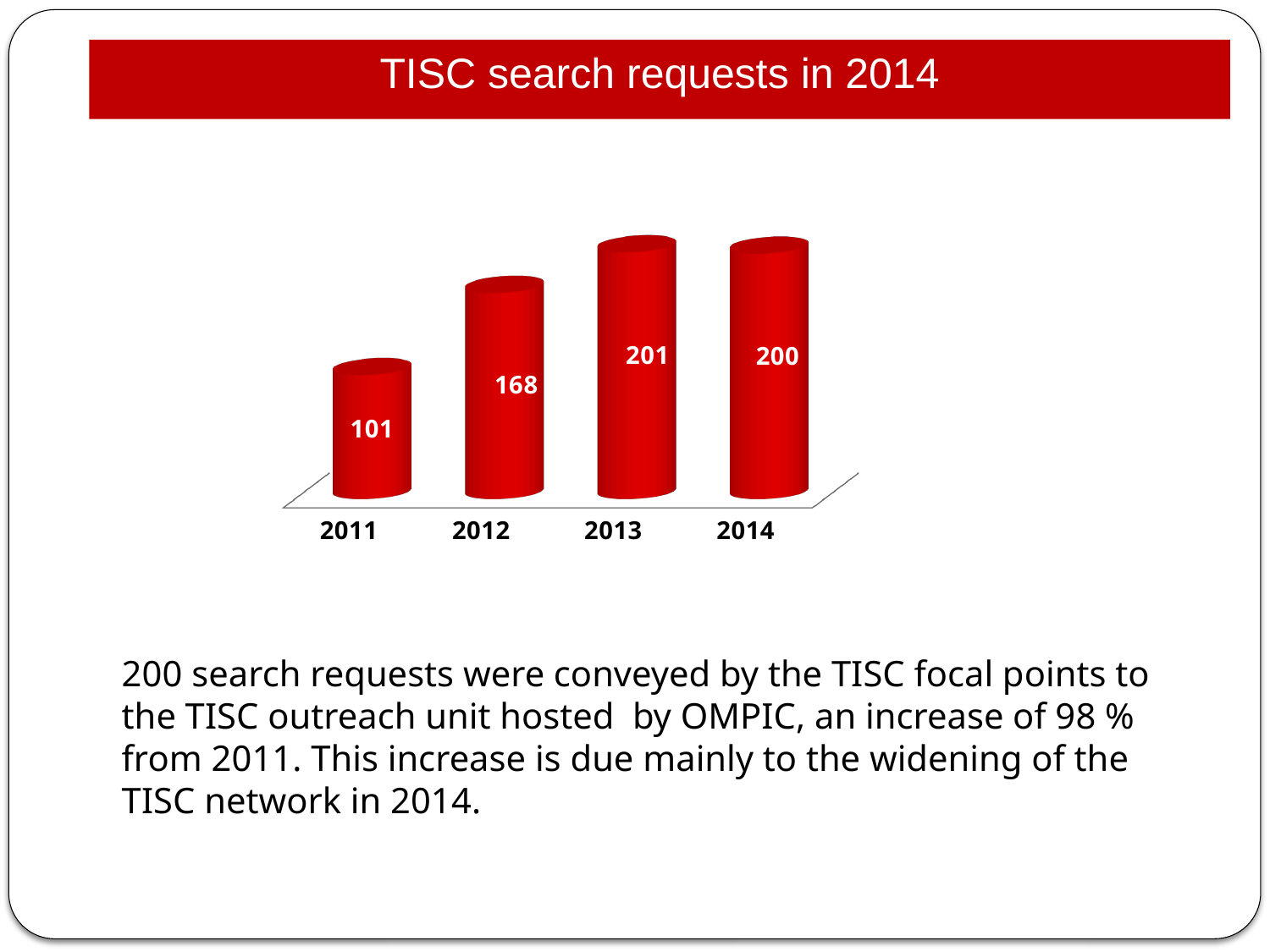
What is the value for 2012? 168 What is the value for 2013? 201 What is the value for 2011? 101 What kind of chart is shown on the slide? bar chart Which is larger, the value for 2012 or the value for 2011? 2012 What is the title of the slide containing the chart? TISC search requests in 2014 What is the difference between the values for 2013 and 2012? 33 Do the values rise or fall from 2011 to 2013? rise What is the value for 2014? 200 What is the difference between the values for 2014 and 2011? 99 How many years are shown on the chart? 4 Which year has the lowest value? 2011